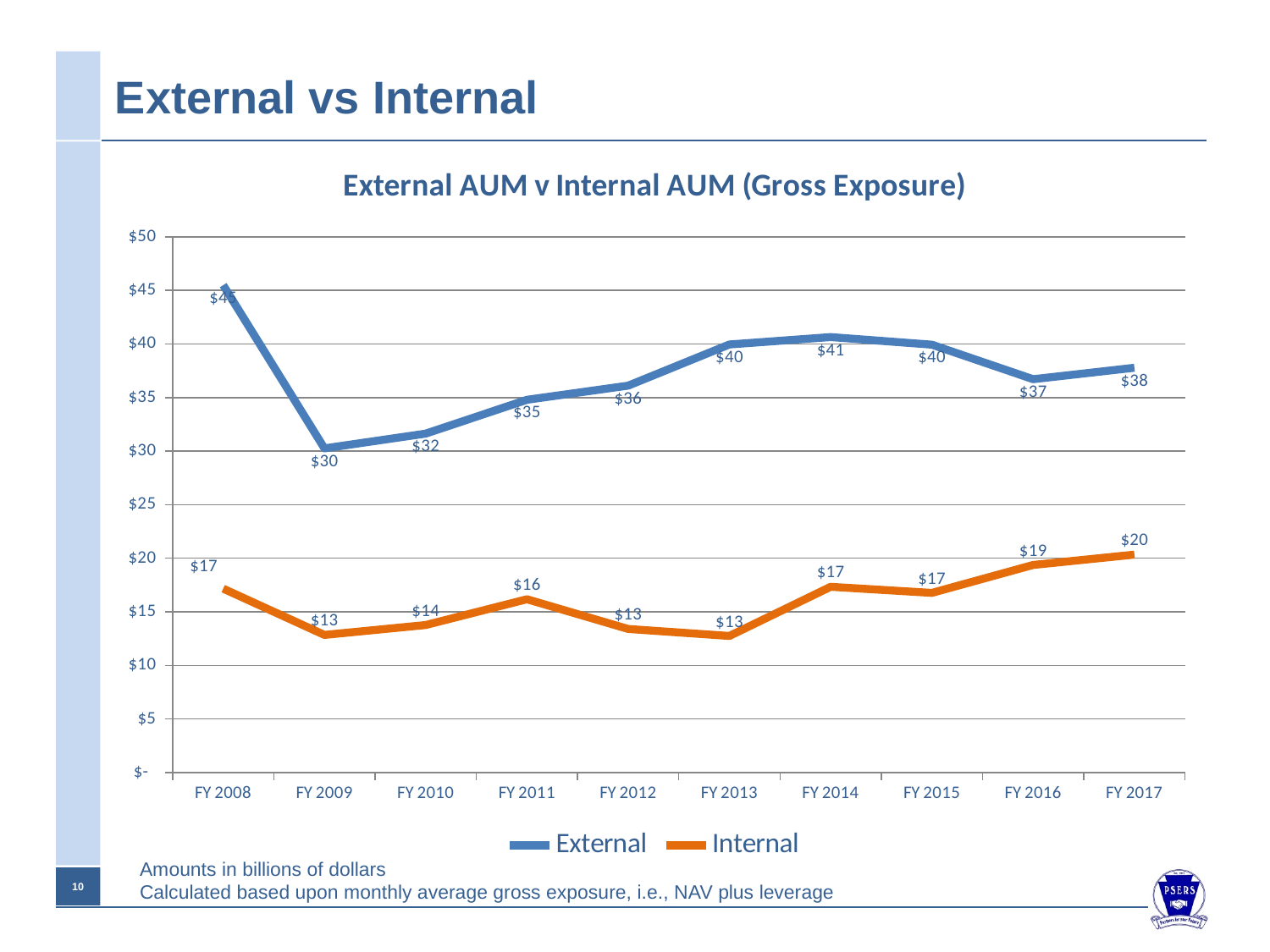
Does the Internal series rise or fall from FY 2013 to FY 2017? Rise How many fiscal years are plotted on the x axis? 10 What is the difference between the External and Internal values in FY 2017? $18 In which fiscal year is the External series at its lowest? FY 2009 How many series does the legend list? 2 Is the External value for FY 2008 greater or less than $40? greater What is the External AUM value for FY 2013? $40 What type of chart is shown on the slide? Line chart What is the External AUM value for FY 2017? $38 In which fiscal year is the Internal series at its highest? FY 2017 Which is larger, the Internal value for FY 2016 or the Internal value for FY 2012? FY 2016 What is the Internal AUM value for FY 2011? $16